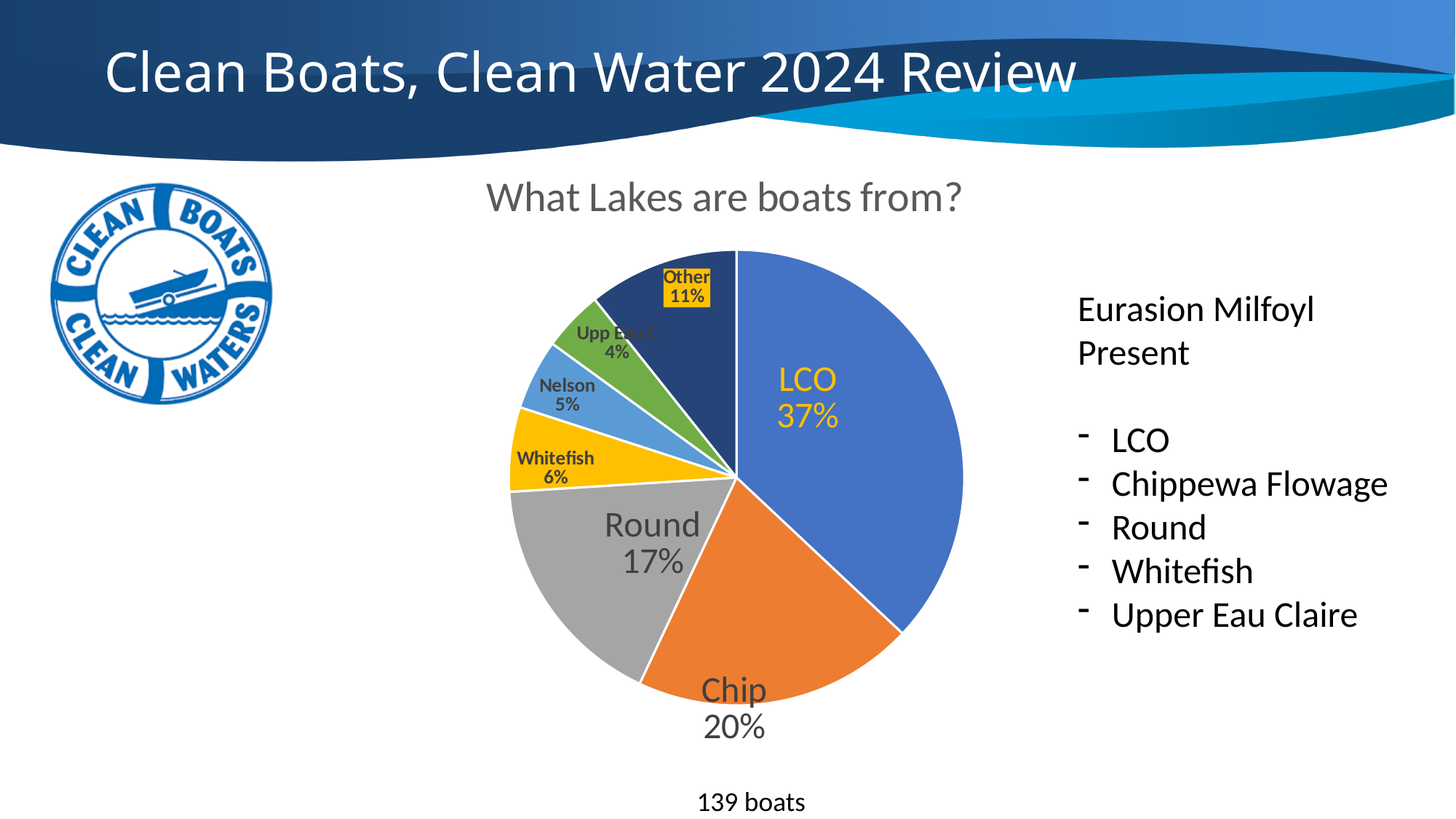
What share of boats are from Whitefish? 6% What share of boats are from Nelson? 5% What is the difference in percentage points between the LCO and Chip shares? 17 Which lake has the largest share of boats? LCO Which lake has the smallest share of boats? Upp Eau C What share of boats are from Round? 17% What share of boats are from LCO? 37% What share of boats are from Upp Eau C? 4% Which has a larger share, Round or Other? Round How many slices does the pie chart have? 7 What share of boats are from Chip? 20% What type of chart is shown on the slide? Pie chart